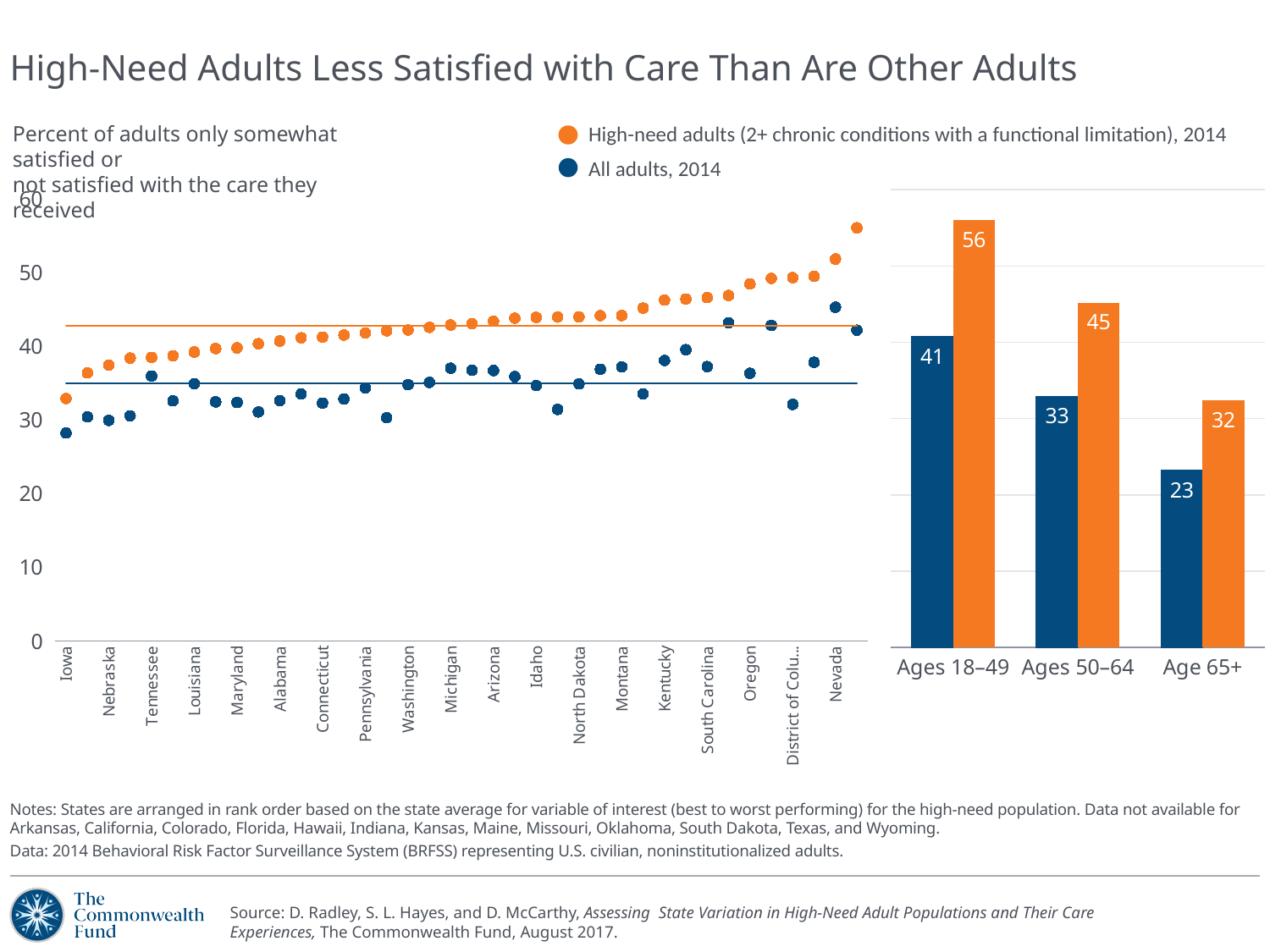
In the bar chart by age group on the right, what is the value for all adults in the Ages 50–64 group? 33 In the bar chart by age group on the right, which age group has the highest value for high-need adults? Ages 18–49 How many series does the legend list? 2 In the bar chart by age group on the right, how many age groups are shown? 3 In the state chart on the left, is the value for high-need adults in Nevada greater or less than 50? greater In the bar chart by age group on the right, what is the value for all adults in the Age 65+ group? 23 In the bar chart by age group on the right, what is the value for high-need adults in the Ages 18–49 group? 56 In the bar chart by age group on the right, which is larger for Ages 50–64: high-need adults or all adults? High-need adults In the bar chart by age group on the right, do the values for high-need adults rise or fall from Ages 18–49 to Age 65+? Fall In the bar chart by age group on the right, which age group has the lowest value for all adults? Age 65+ In the bar chart by age group on the right, what is the difference between high-need adults and all adults in the Age 65+ group? 9 In the bar chart by age group on the right, what is the difference between high-need adults and all adults in the Ages 18–49 group? 15